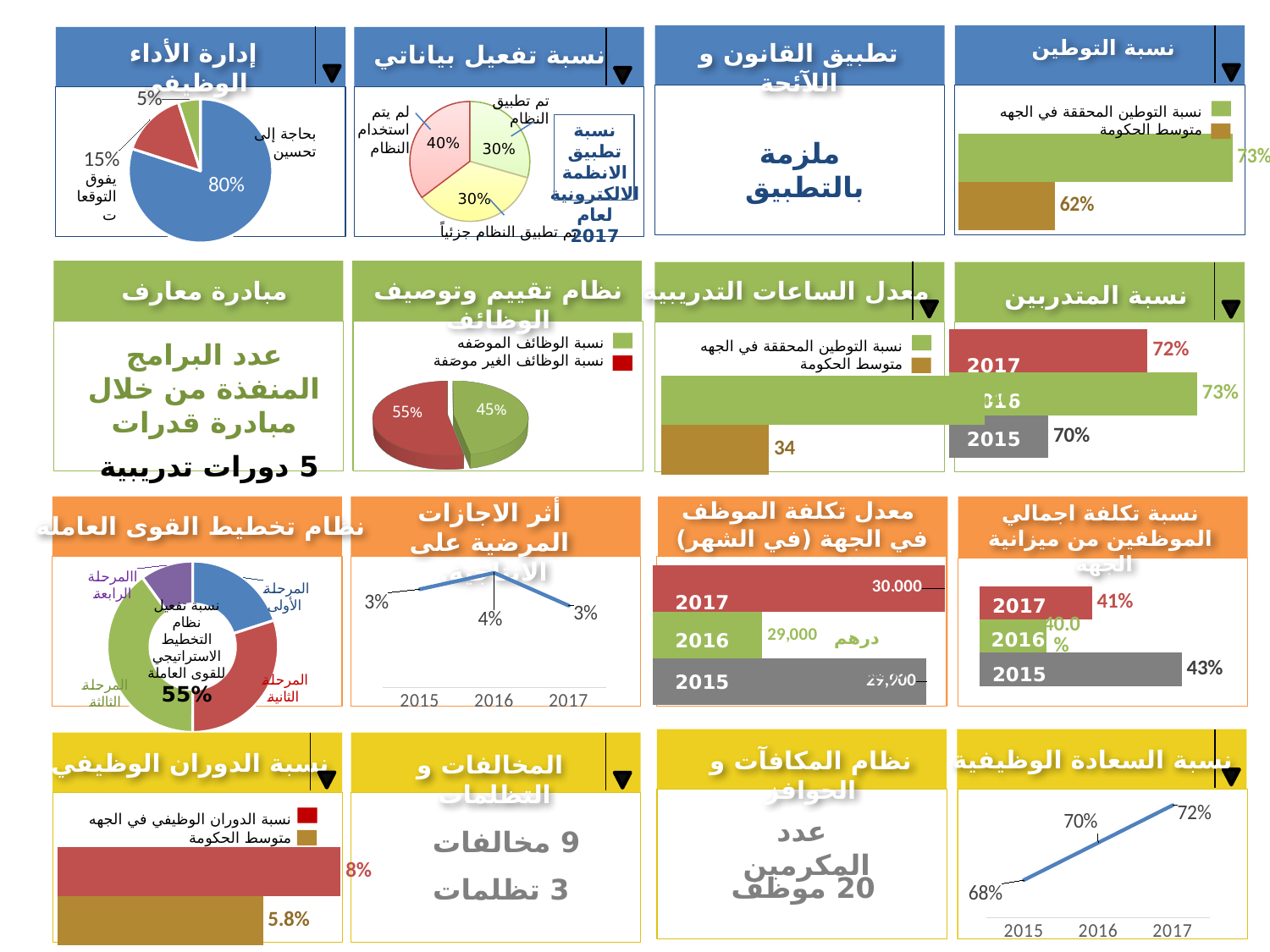
In the "إدارة الأداء الوظيفي" pie chart, what is the largest slice's value? 80% In the "نسبة التوطين" bar chart, what is the value for "نسبة التوطين المحققة في الجهة"? 73% In the "نسبة التوطين" bar chart, what is the difference between the entity's value and "متوسط الحكومة"? 11% In the "نسبة الدوران الوظيفي" bar chart, what is the value for "متوسط الحكومة"? 5.8% In the "نسبة المتدربين" bar chart, what is the value for 2017? 72% In the "نسبة تفعيل بياناتي" pie chart, what percentage is shown for "لم يتم استخدام النظام"? 40% In the "نظام تقييم وتوصيف الوظائف" pie chart, what share is "نسبة الوظائف الغير موصفة"? 55% In the "نسبة المتدربين" bar chart, which year has the lowest value? 2015 In the "أثر الاجازات المرضية" line chart, what is the value for 2016? 4% In the "نسبة السعادة الوظيفية" line chart, do the values rise or fall from 2015 to 2017? rise In the "نسبة تكلفة اجمالي الموظفين من ميزانية الجهة" bar chart, what is the value for 2015? 43% In the "معدل تكلفة الموظف في الجهة (في الشهر)" bar chart, which is larger, 2017 or 2016? 2017